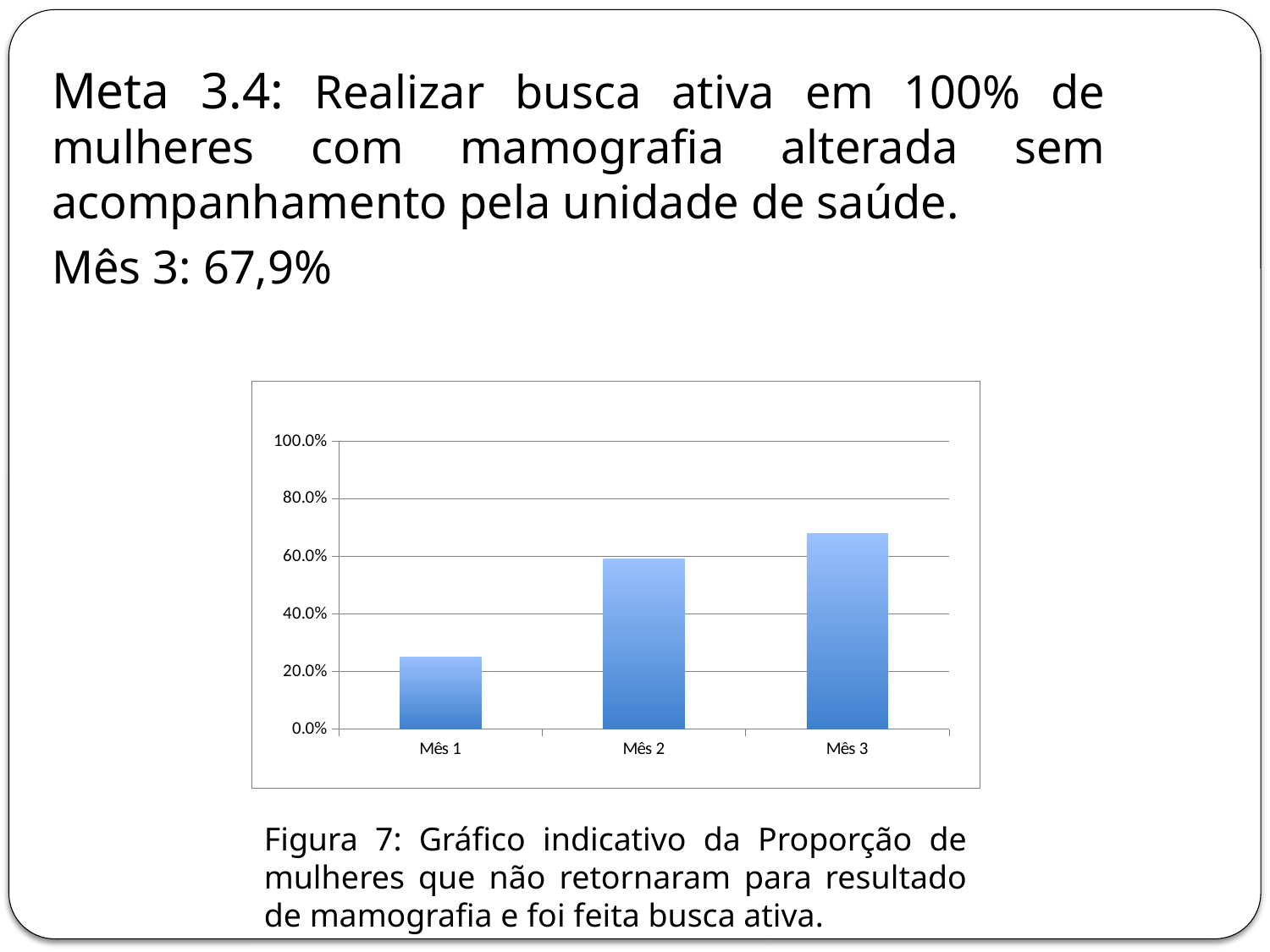
Which month has the lowest bar on the chart? Mês 1 Which is larger, the value for Mês 1 or the value for Mês 2? Mês 2 Do the values rise or fall from Mês 1 to Mês 3? rise How many categories (months) are plotted on the chart? 3 According to the text on the slide, what is the value for Mês 3? 67,9% What kind of chart is shown on the slide? bar chart Is the value for Mês 1 greater or less than 40.0%? less Is the value for Mês 1 greater or less than 20.0%? greater Is the value for Mês 2 greater or less than 40.0%? greater Which month has the highest bar on the chart? Mês 3 What is the highest value shown on the chart's vertical axis? 100.0%